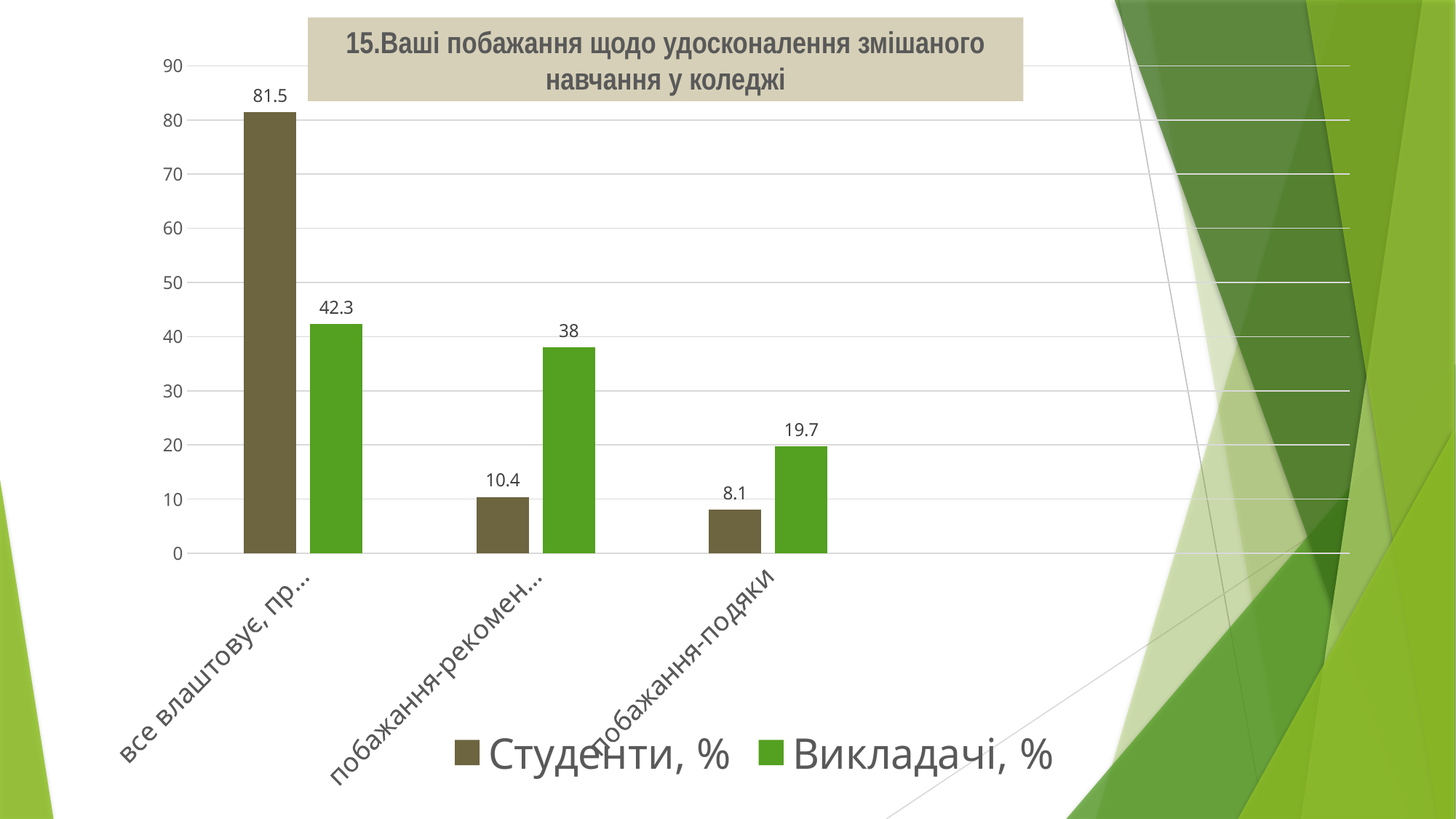
Do the values for Студенти, % rise or fall from left to right along the x axis? fall Which category has the highest value for Студенти, %? все влаштовує, пр... What is the value for Студенти, % in the first category ("все влаштовує, пр...")? 81.5 How many categories are shown on the x axis? 3 What is the value for Викладачі, % in the category "побажання-подяки"? 19.7 Which category has the lowest value for Викладачі, %? побажання-подяки What is the value for Студенти, % in the category "побажання-подяки"? 8.1 How many series does the legend list? 2 In the category "побажання-подяки", which series has the larger value, Студенти, % or Викладачі, %? Викладачі, % What is the value for Викладачі, % in the second category ("побажання-рекомен...")? 38 What is the difference between Студенти, % and Викладачі, % in the first category ("все влаштовує, пр...")? 39.2 What kind of chart is shown on the slide? bar chart